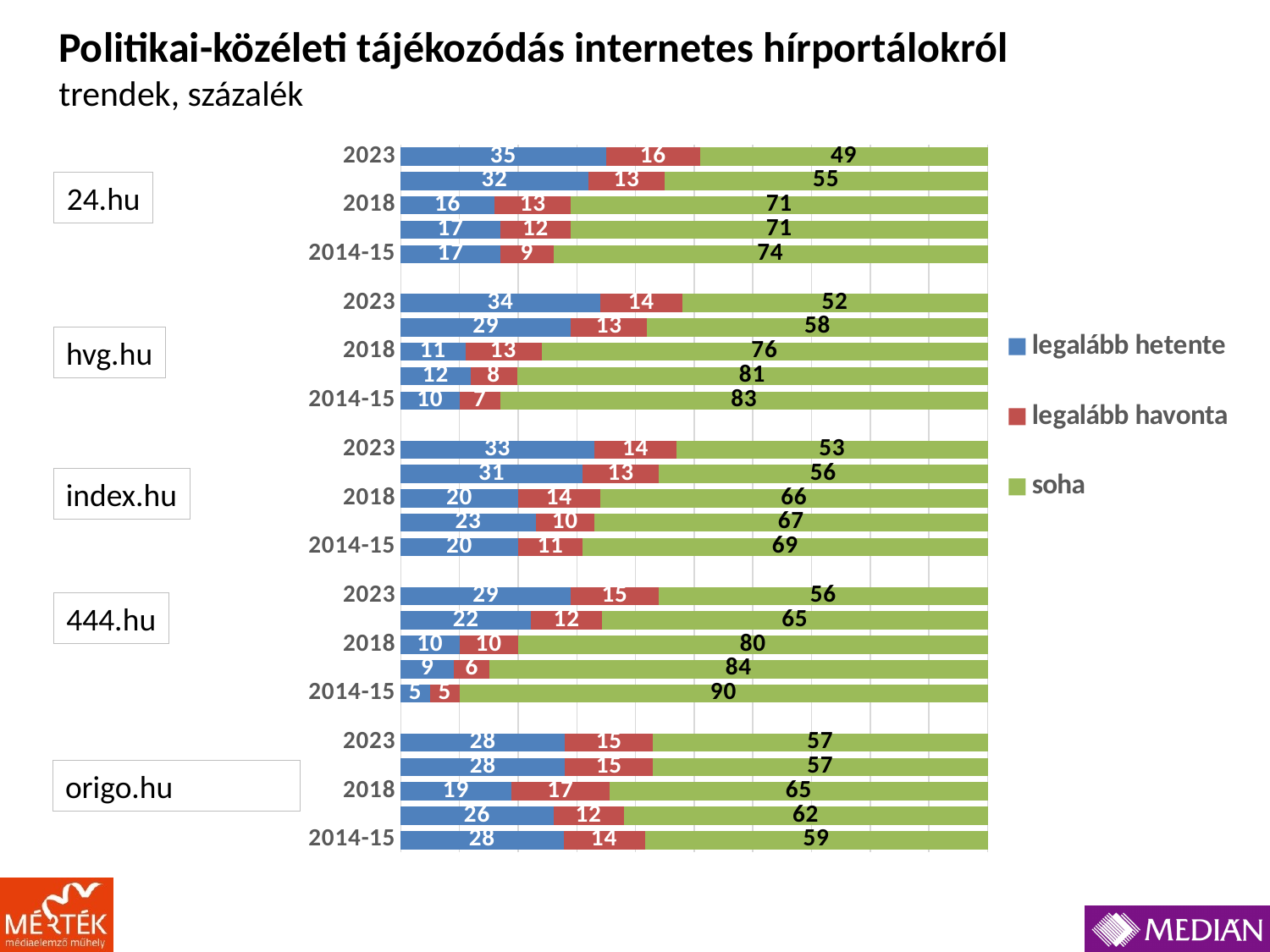
Which has the larger 'legalább hetente' value in 2023: hvg.hu or index.hu? hvg.hu What is the 'legalább havonta' value for origo.hu in 2018? 17 How many news portals are shown in the chart? 5 What is the total of the stacked bar for 444.hu in 2014-15? 100 What is the value for 'legalább hetente' for 24.hu in 2023? 35 Which news portal has the highest 'soha' value in 2023? origo.hu How many series does the legend list? 3 Which news portal has the lowest 'legalább hetente' value in 2014-15? 444.hu What kind of chart is shown on the slide? Stacked bar chart What is the 'soha' value for 444.hu in 2014-15? 90 Does the 'soha' value for 24.hu rise or fall from 2014-15 to 2023? Fall By how much did the 'legalább hetente' value for 24.hu increase from 2014-15 to 2023? 18